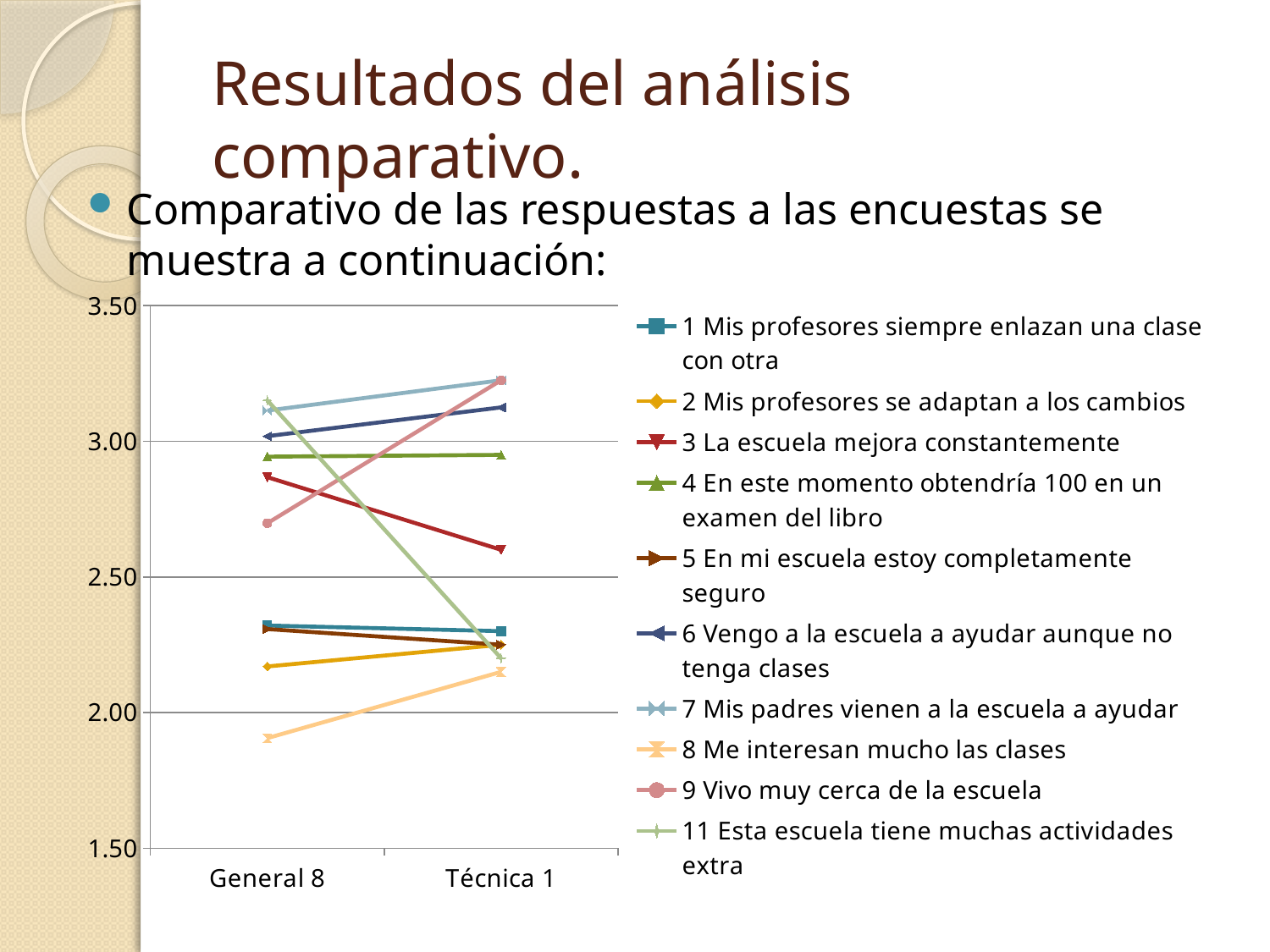
Is the value for series 9 'Vivo muy cerca de la escuela' at Técnica 1 greater or less than 3.00? greater What kind of chart is shown on the slide? line chart Which series has the lowest value at General 8? 8 Me interesan mucho las clases How many series does the chart's legend list? 10 Does the line for series 8 'Me interesan mucho las clases' rise or fall from General 8 to Técnica 1? rise Does the line for series 3 'La escuela mejora constantemente' rise or fall from General 8 to Técnica 1? fall Does the line for series 11 'Esta escuela tiene muchas actividades extra' rise or fall from General 8 to Técnica 1? fall What are the two categories on the x axis of the chart? General 8 and Técnica 1 At Técnica 1, which is larger: the value for series 9 'Vivo muy cerca de la escuela' or series 3 'La escuela mejora constantemente'? 9 Vivo muy cerca de la escuela Is the value for series 8 'Me interesan mucho las clases' at General 8 greater or less than 2.00? less How many categories are shown on the x axis of the chart? 2